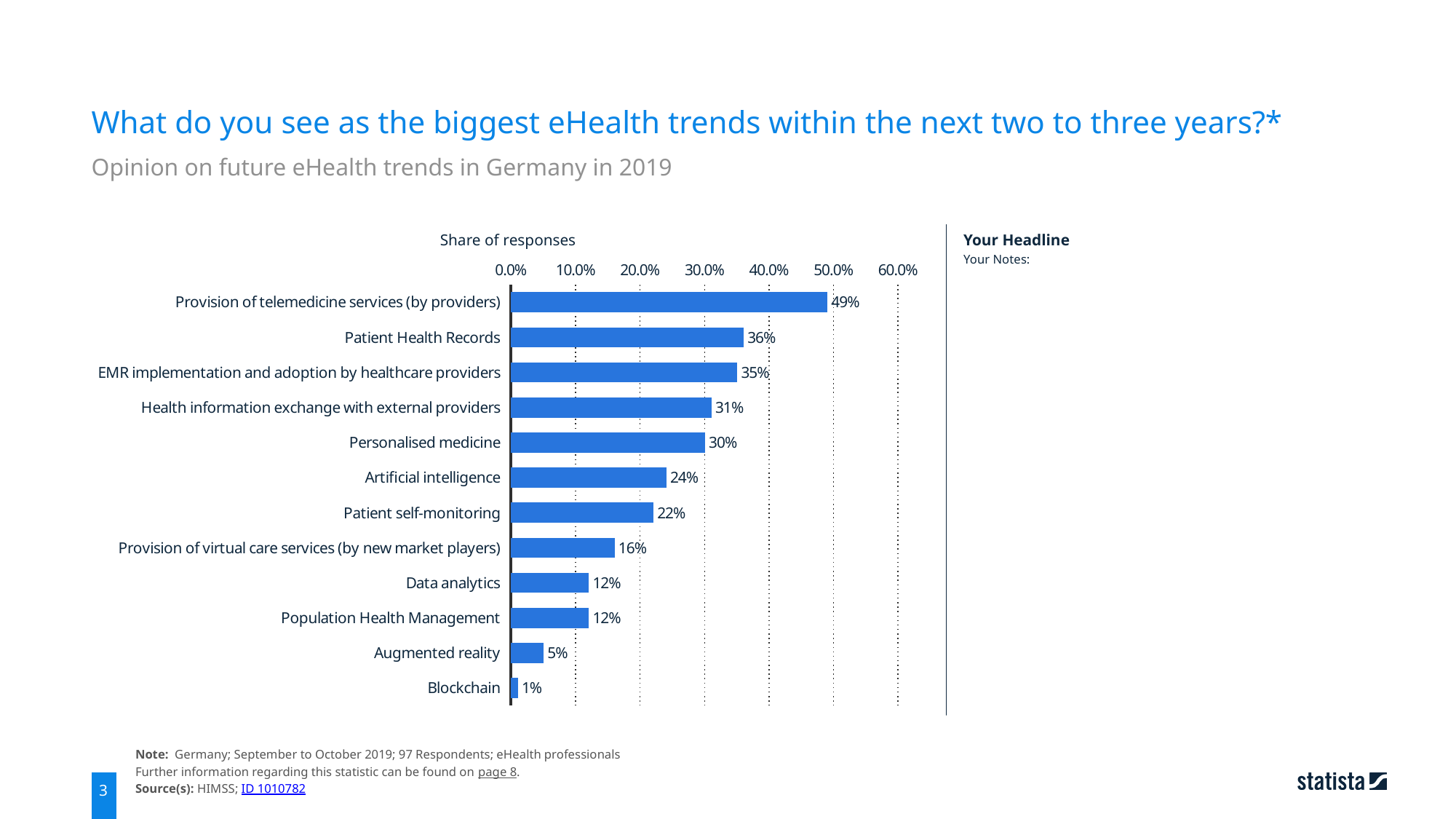
Which has a larger share of responses, Health information exchange with external providers or Artificial intelligence? Health information exchange with external providers Which category has the lowest share of responses? Blockchain How many categories are shown in the chart? 12 What is the difference between the shares for Patient Health Records and Personalised medicine? 6% What is the label of the value axis of the chart? Share of responses Is the value for EMR implementation and adoption by healthcare providers greater or less than 30.0%? greater What kind of chart is shown on the slide? Bar chart Which category has the highest share of responses? Provision of telemedicine services (by providers) What share of responses is shown for Augmented reality? 5% What share of responses is shown for Artificial intelligence? 24% What share of responses is shown for Provision of telemedicine services (by providers)? 49% What is the difference between the shares for Patient self-monitoring and Provision of virtual care services (by new market players)? 6%